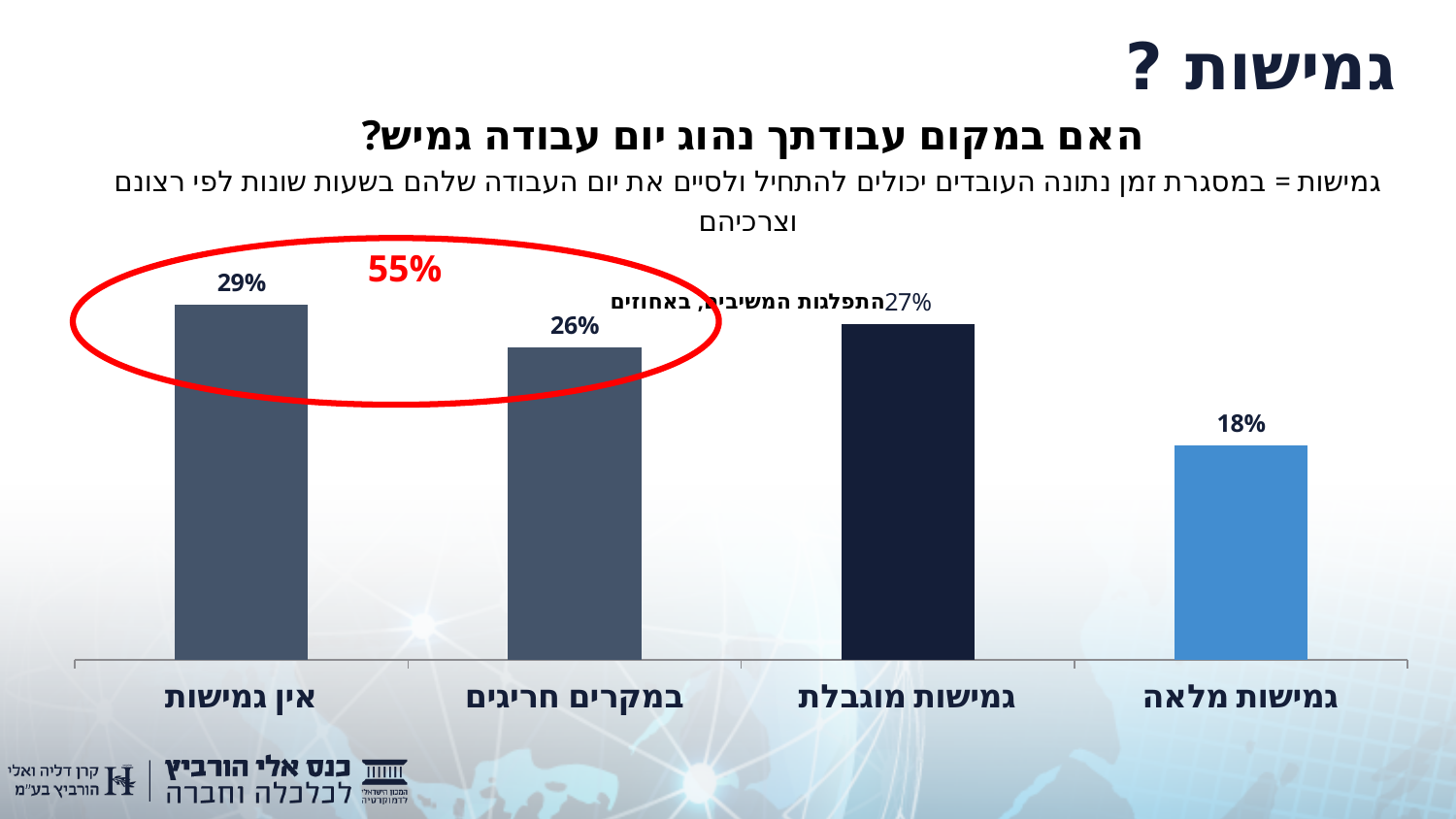
How many categories are shown in the chart? 4 What percentage is written inside the red circle drawn over the first two bars? 55% Which category has the highest value? אין גמישות What is the value for במקרים חריגים? 26% What is the value for אין גמישות? 29% Which is larger, the value for אין גמישות or the value for גמישות מלאה? אין גמישות What is the difference between the values for אין גמישות and גמישות מלאה? 11% What is the difference between the values for גמישות מוגבלת and במקרים חריגים? 1% What is the value for גמישות מלאה? 18% What kind of chart is shown on the slide? Bar chart What is the value for גמישות מוגבלת? 27% Which category has the lowest value? גמישות מלאה